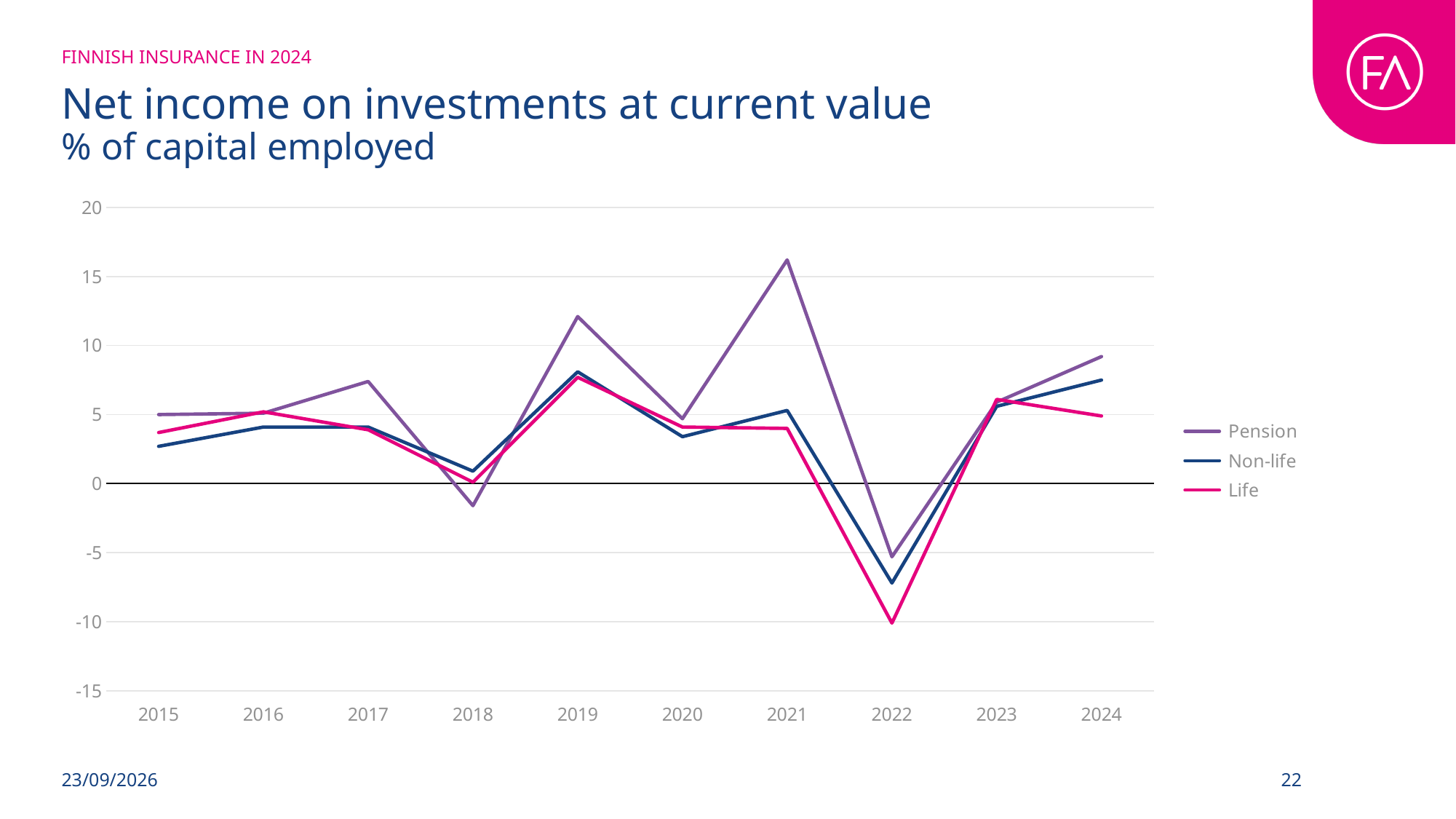
In which year does the Pension series reach its highest value? 2021 Which is larger in 2024, the Pension value or the Life value? Pension What kind of chart is shown on the slide? line chart Is the value for Life in 2022 greater or less than -5? less In which year does the Life series reach its lowest value? 2022 Is the value for Pension in 2018 greater or less than 0? less How many years are shown on the x axis? 10 How many series does the legend list? 3 Which series has the highest value in 2021? Pension Does the Pension series rise or fall from 2022 to 2024? rise Is the value for Pension in 2021 greater or less than 15? greater Which series has the lowest value in 2022? Life